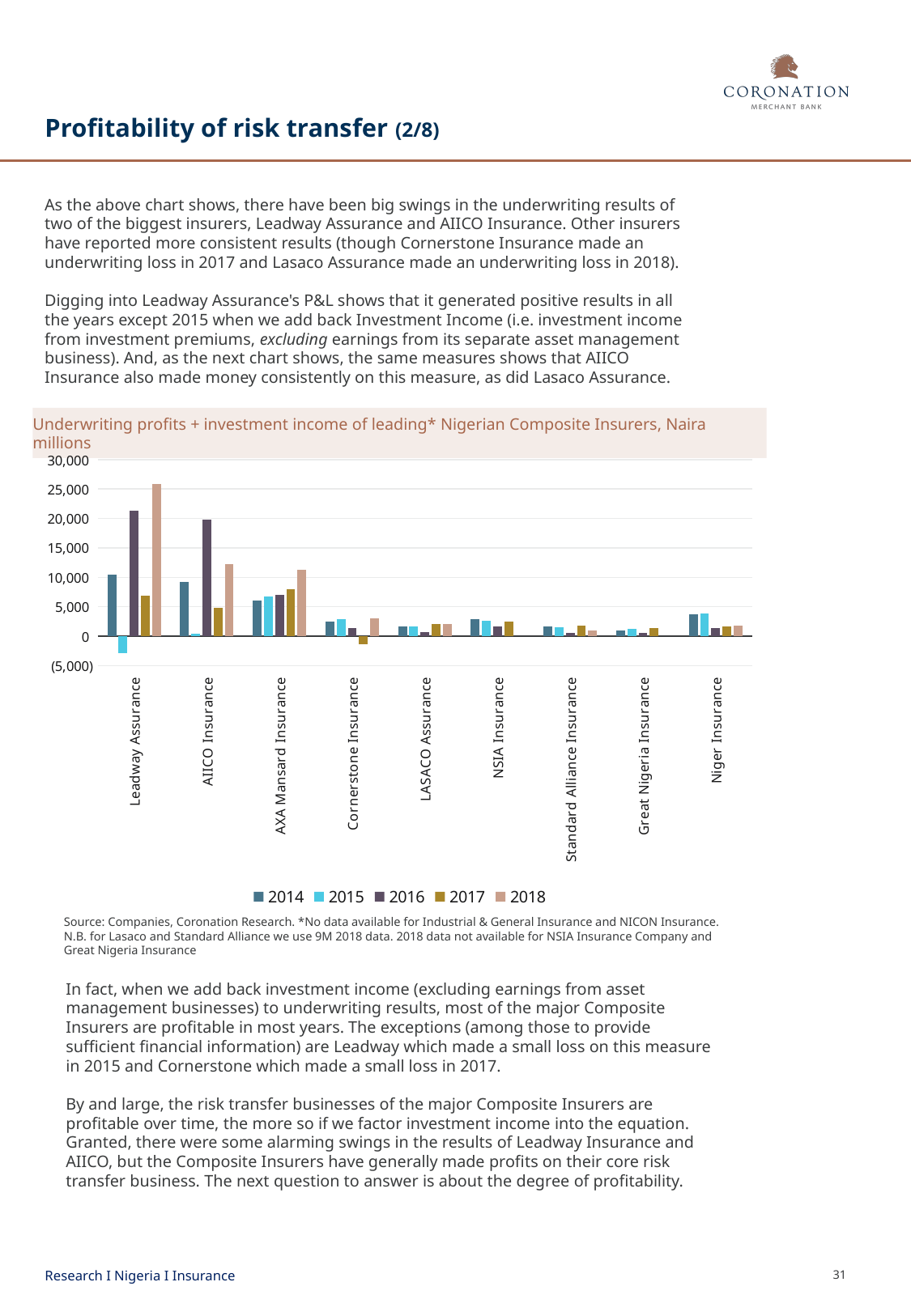
Which years are listed in the chart's legend? 2014, 2015, 2016, 2017, 2018 What kind of chart is shown on the slide? Bar chart Which insurer has the tallest bar in the chart? Leadway Assurance Which insurer and year has the lowest value in the chart? Leadway Assurance, 2015 How many insurers are shown on the x axis of the chart? 9 How many series does the chart's legend list? 5 Is the 2015 value for Leadway Assurance greater or less than 0? less What is the title of the chart? Underwriting profits + investment income of leading* Nigerian Composite Insurers, Naira millions Which is larger, the 2018 value for Leadway Assurance or the 2018 value for AIICO Insurance? Leadway Assurance Is the 2017 value for Cornerstone Insurance greater or less than 0? less Is the 2018 value for Leadway Assurance greater or less than 20,000? greater